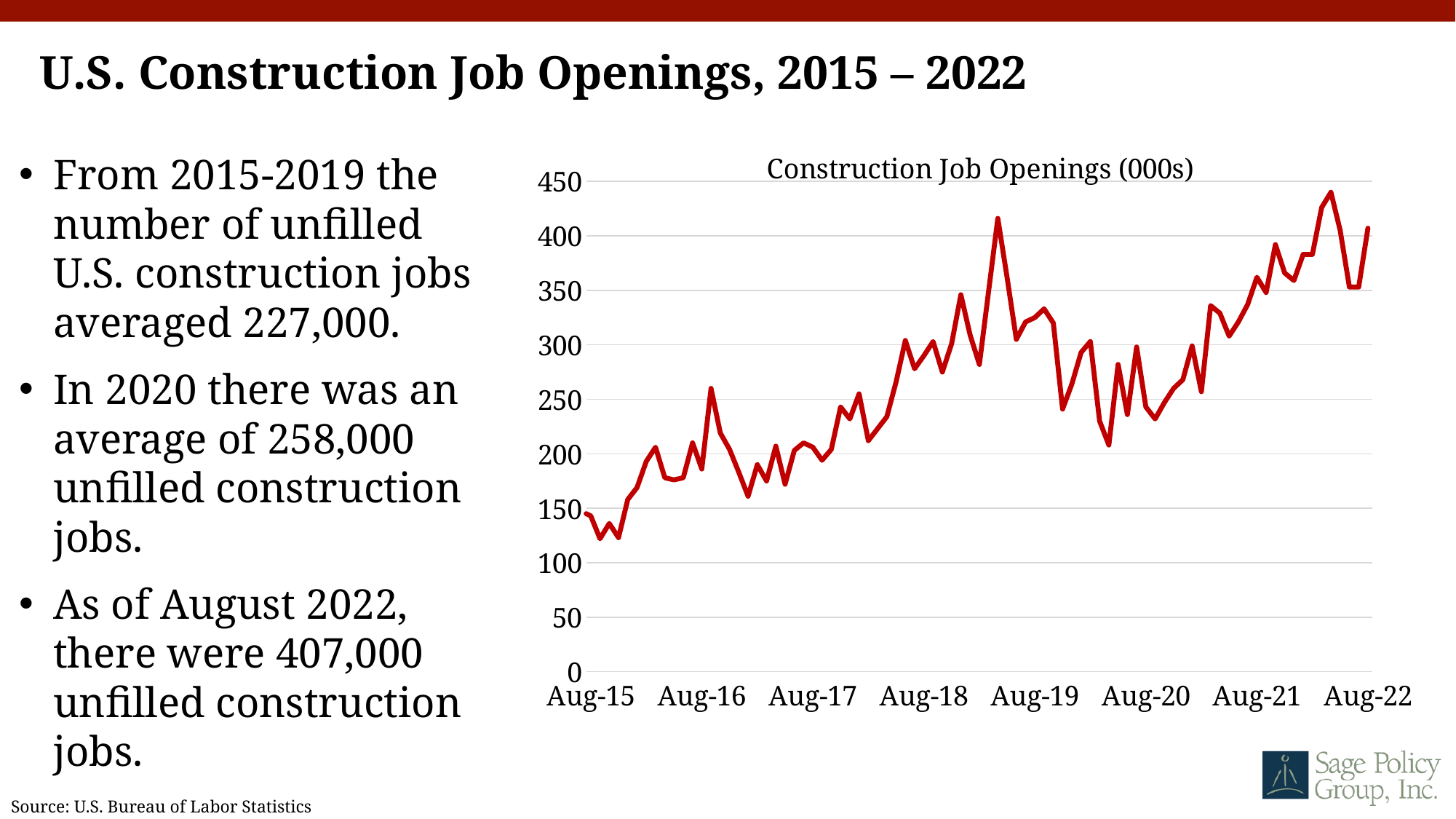
How many labelled tick marks are on the x axis of the chart? 8 Is the value at Aug-21 greater or less than 300? greater Is the lowest point on the line greater or less than 150? less Is the value at Aug-22 greater or less than 350? greater How many lines (series) are plotted in the chart? 1 What colour is the line in the chart? red What is the title of the chart? Construction Job Openings (000s) Overall, do construction job openings rise or fall from Aug-15 to Aug-22? rise What kind of chart is shown on the slide? line chart